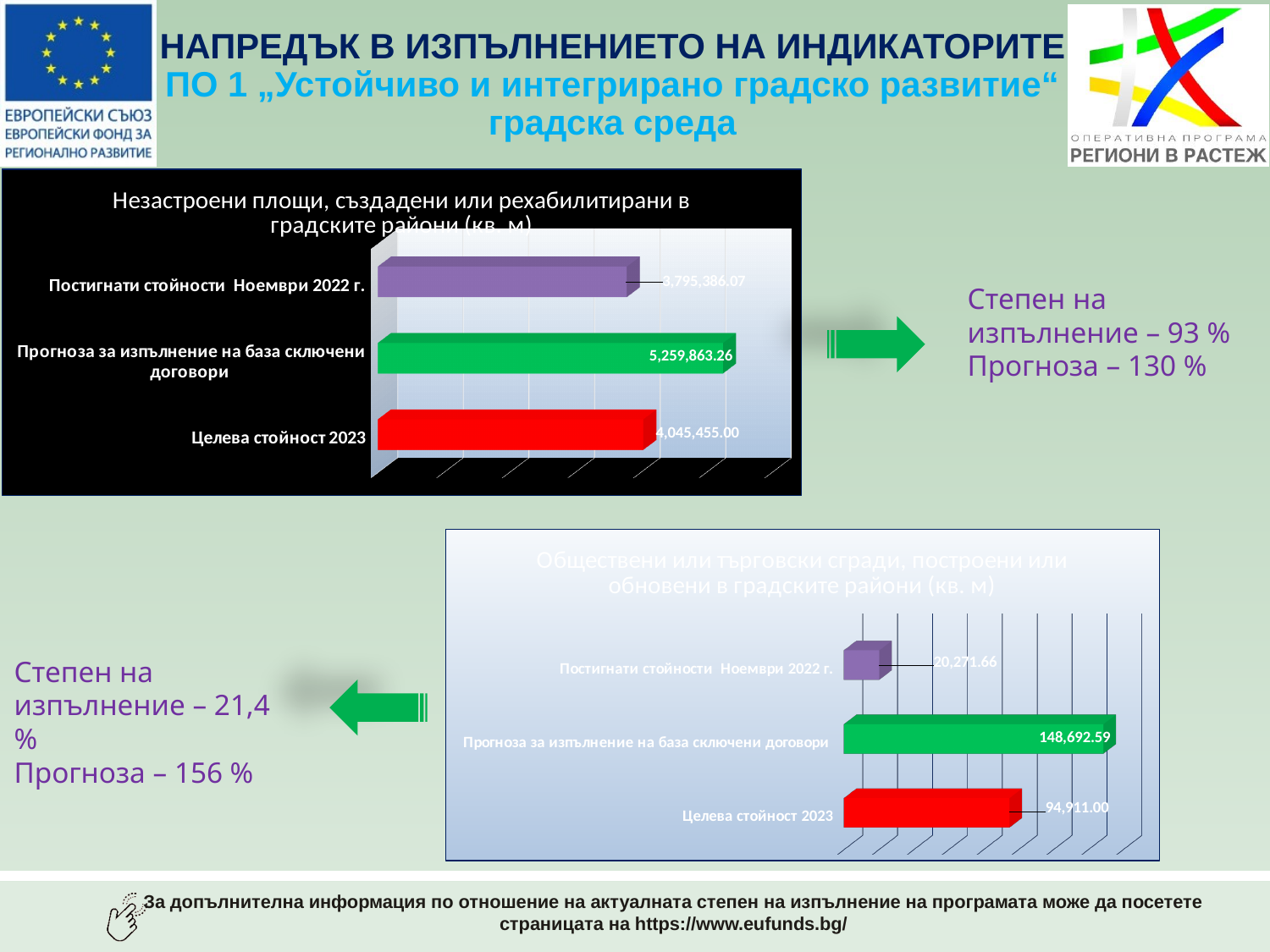
On the bottom chart, what is the value for Целева стойност 2023? 94,911.00 On the top chart (Незастроени площи, създадени или рехабилитирани в градските райони), what is the value for Прогноза за изпълнение на база сключени договори? 5,259,863.26 On the top chart, which category has the lowest value? Постигнати стойности Ноември 2022 г. What type of chart is the top chart? Bar chart On the top chart, what is the value for Целева стойност 2023? 4,045,455.00 On the bottom chart, which category has the lowest value? Постигнати стойности Ноември 2022 г. On the bottom chart, what is the difference between Целева стойност 2023 and Постигнати стойности Ноември 2022 г.? 74,639.34 On the top chart, what is the difference between Прогноза за изпълнение на база сключени договори and Целева стойност 2023? 1,214,408.26 On the top chart, how many bars are plotted? 3 On the bottom chart, what is the value for Прогноза за изпълнение на база сключени договори? 148,692.59 On the top chart, which category has the highest value? Прогноза за изпълнение на база сключени договори On the top chart, what is the value for Постигнати стойности Ноември 2022 г.? 3,795,386.07